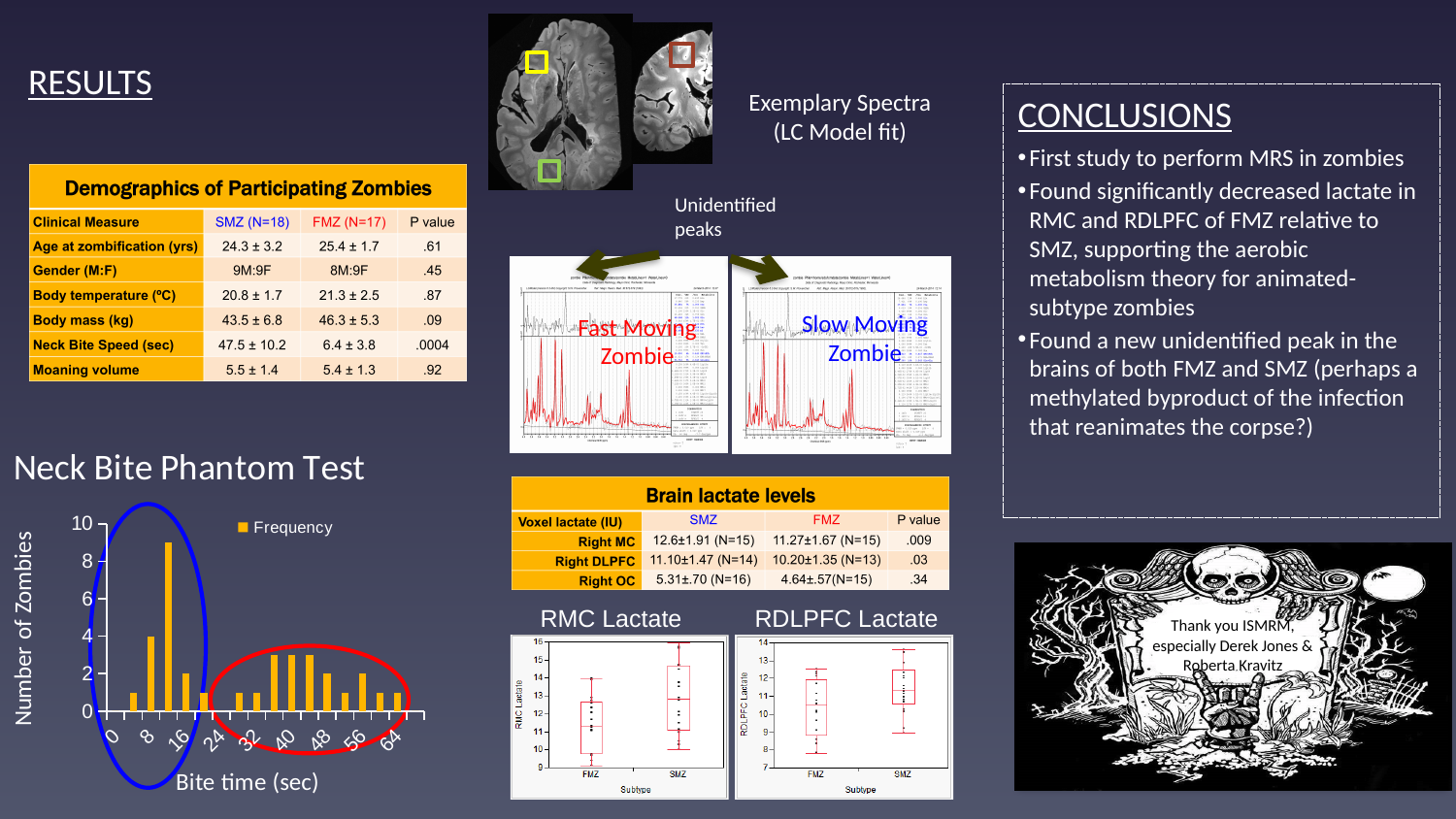
What is the x-axis title of the Neck Bite Phantom Test chart? Bite time (sec) On the Neck Bite Phantom Test chart, is the number of zombies at bite time 40 greater or less than 4? less How many series does the legend of the Neck Bite Phantom Test chart list? 1 How many subtype categories are shown on the x axis of the RMC Lactate chart? 2 On the Neck Bite Phantom Test chart, is the number of zombies at bite time 8 greater or less than 6? less On the Neck Bite Phantom Test chart, which has more zombies: bite time 8 or bite time 40? 8 What kind of chart is the Neck Bite Phantom Test chart? bar chart On the Neck Bite Phantom Test chart, is the number of zombies at bite time 0 greater or less than 2? less What is the legend entry on the Neck Bite Phantom Test chart? Frequency